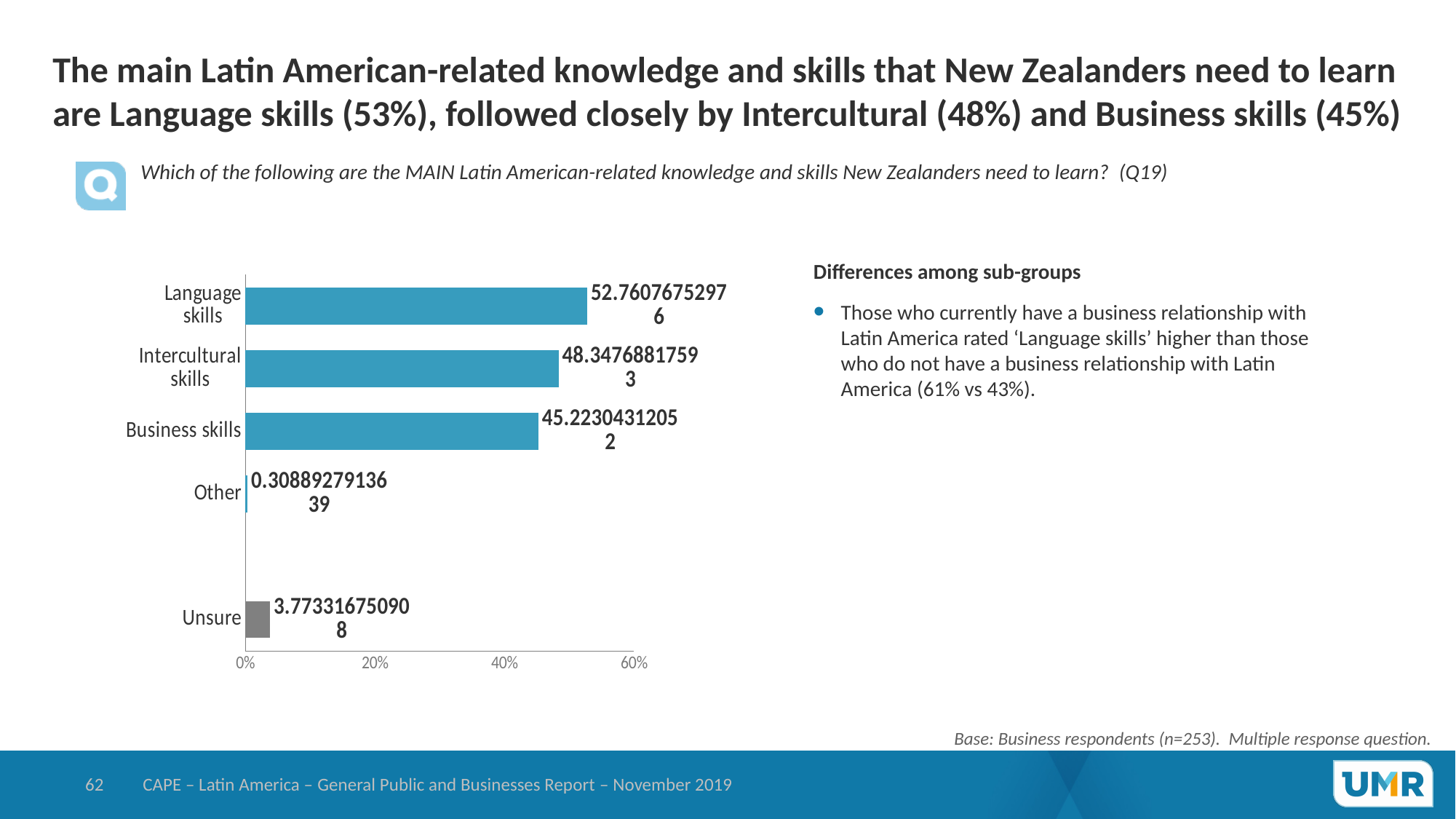
Which category has the highest value? Language skills Which category has the lowest value? Other What colour is the bar for Unsure? grey Which is larger, the value for Intercultural skills or the value for Business skills? Intercultural skills What kind of chart is shown on the slide? bar chart What is the value shown for Intercultural skills? 48.34768817593 Is the value for Language skills greater or less than 40%? greater What is the value shown for Unsure? 3.773316750908 How many categories are shown in the chart? 5 What is the value shown for Language skills? 52.76076752976 What is the value shown for Other? 0.3088927913639 What is the value shown for Business skills? 45.22304312052